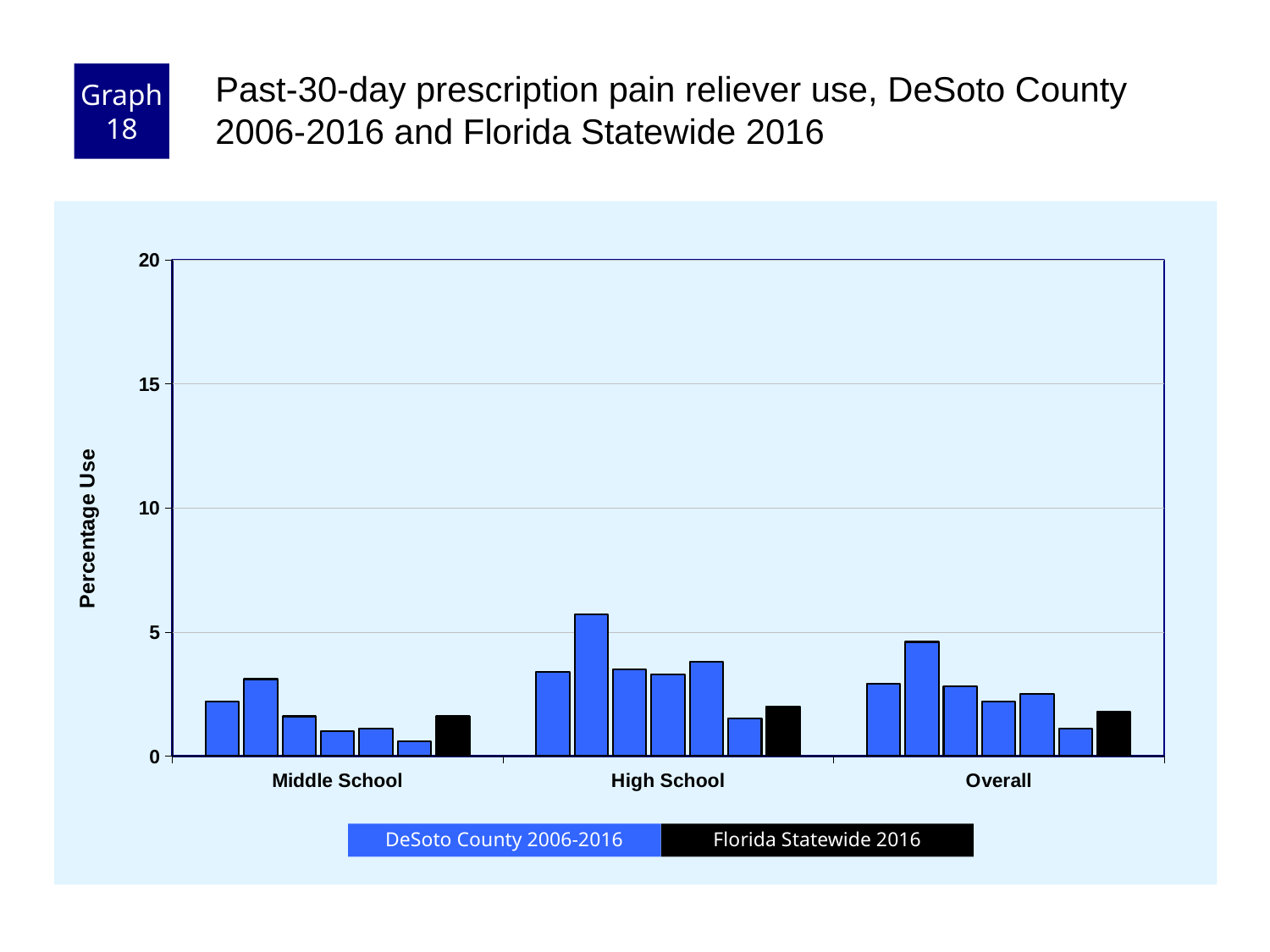
Are any bars on the chart greater than 10? No Is the tallest bar in the High School group greater or less than 5? greater Which colour represents Florida Statewide 2016 in the legend? Black How many series does the legend list? 2 Is the Florida Statewide 2016 value for High School greater or less than 5? less Which is larger: the Florida Statewide 2016 value for High School or for Middle School? High School How many categories are shown along the x axis? 3 Which category group contains the tallest bar on the chart? High School What is the label of the y axis? Percentage Use What kind of chart is shown on the slide? Bar chart